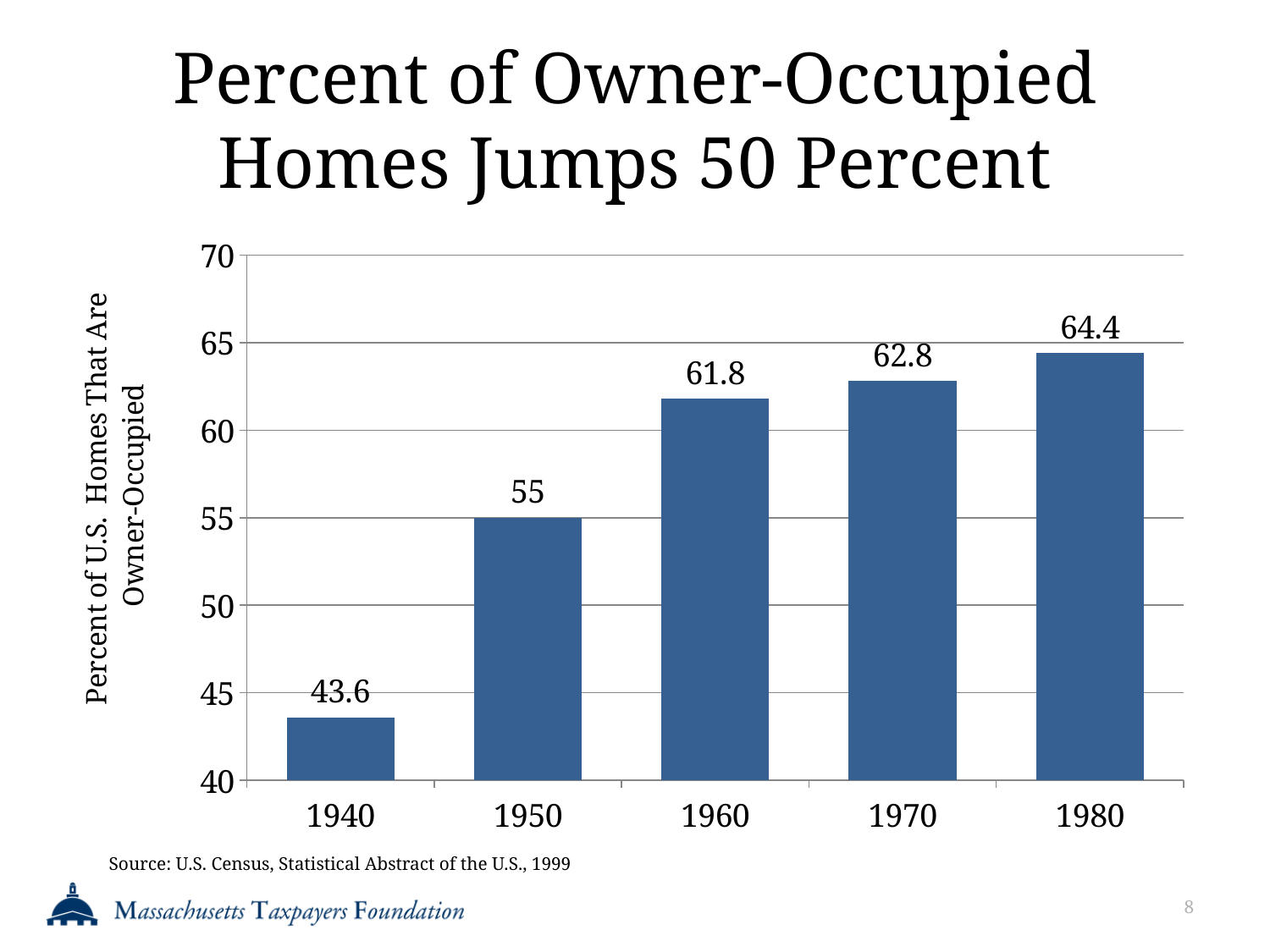
Is the value for 1970 greater or less than 60? greater Which year has the highest percent of owner-occupied homes? 1980 What is the difference between the 1950 and 1940 values? 11.4 What is the difference between the 1980 and 1970 values? 1.6 Which year has the lowest percent of owner-occupied homes? 1940 What is the percent of owner-occupied homes in 1980? 64.4 Which is larger, the value for 1950 or the value for 1960? 1960 What is the percent of owner-occupied homes in 1960? 61.8 How many years are shown on the x axis? 5 What is the percent of owner-occupied homes in 1940? 43.6 Do the values rise or fall from 1940 to 1980? rise What kind of chart is shown on the slide? bar chart